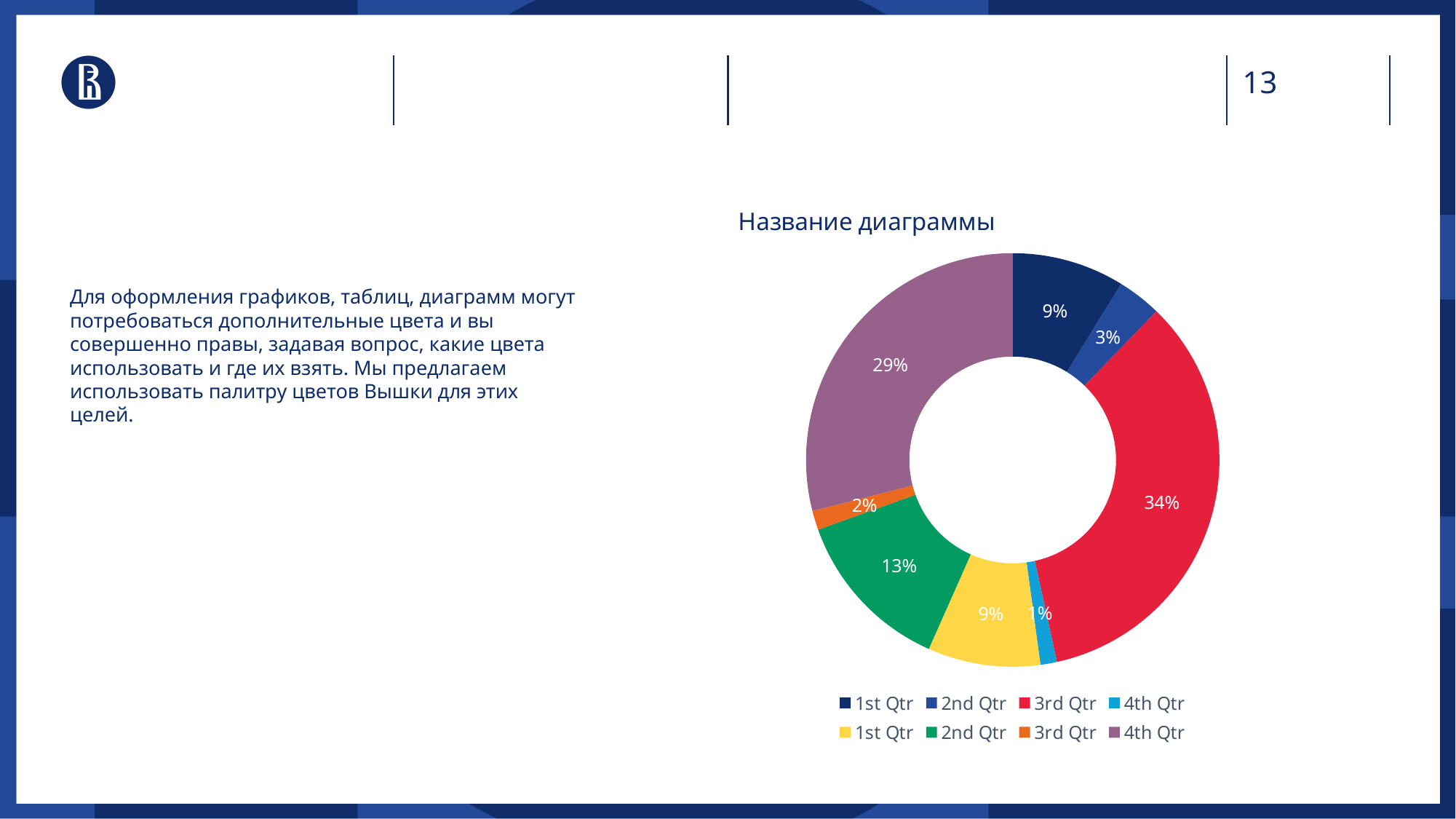
How many entries does the chart legend list? 8 What percentage is shown on the red slice (3rd Qtr)? 34% Which slice has the largest share of the doughnut? The red slice (3rd Qtr), 34% How many slices does the doughnut chart have? 8 What is the difference between the red slice (34%) and the purple slice (29%)? 5% What percentage is shown on the purple slice (4th Qtr)? 29% Which slice has the smallest share of the doughnut? The light blue slice (4th Qtr), 1% What percentage is shown on the dark navy slice (1st Qtr)? 9% Which is larger, the green slice or the yellow slice? The green slice (13%) What percentage is shown on the green slice (2nd Qtr)? 13% What is the title of the chart? Название диаграммы What kind of chart is shown on the slide? Doughnut (pie) chart